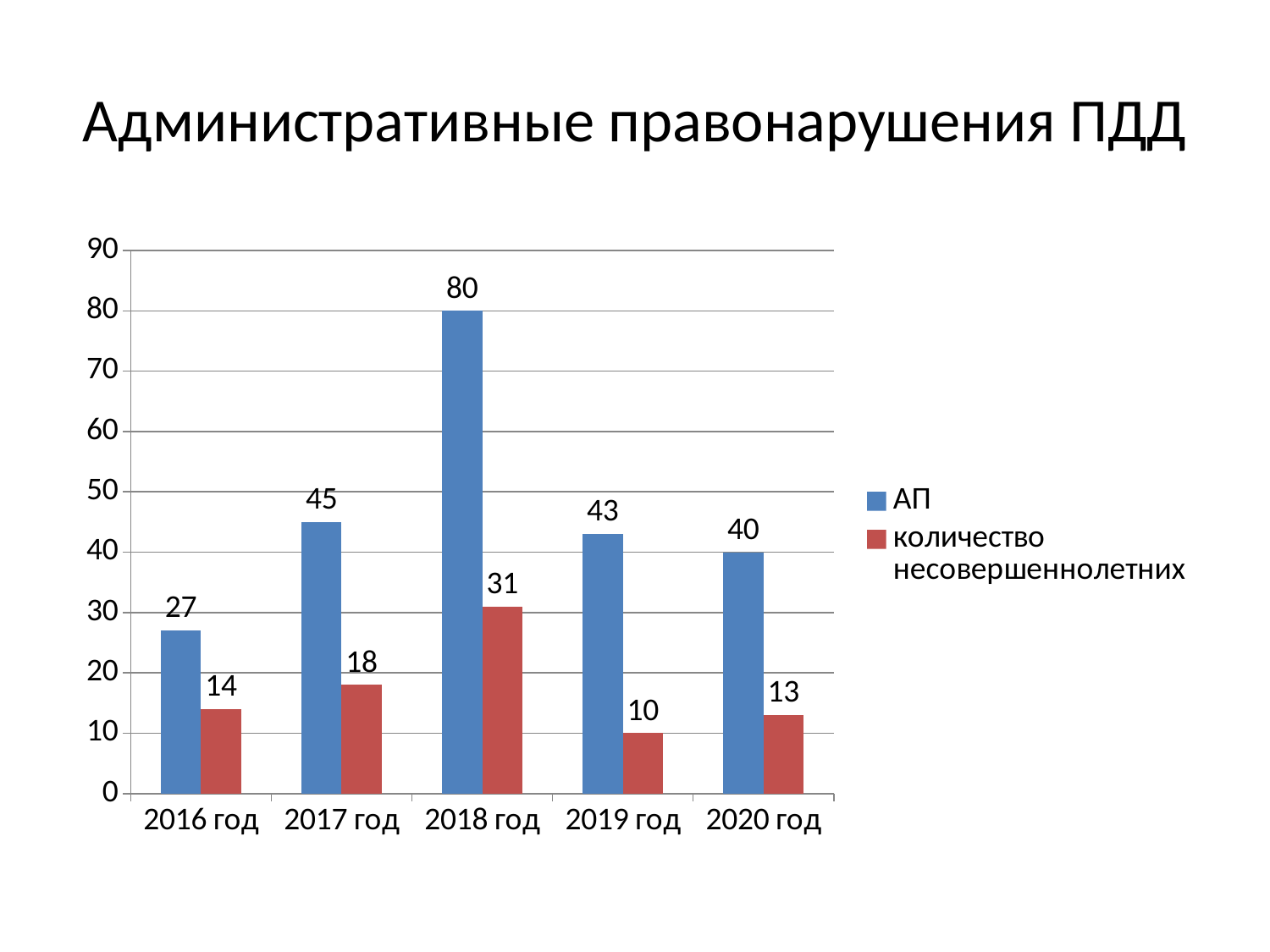
Which year has the highest value for АП? 2018 год How many series does the legend list? 2 Which year has the lowest value for количество несовершеннолетних? 2019 год What is the value of АП for 2016 год? 27 How many years are shown on the x axis? 5 Is the value of АП for 2020 год greater or less than 50? less What is the title of the slide? Административные правонарушения ПДД Which is larger: АП in 2017 год or АП in 2019 год? АП in 2017 год What kind of chart is shown on the slide? bar chart What is the difference between АП and количество несовершеннолетних in 2018 год? 49 What is the value of количество несовершеннолетних for 2019 год? 10 What is the value of АП for 2018 год? 80